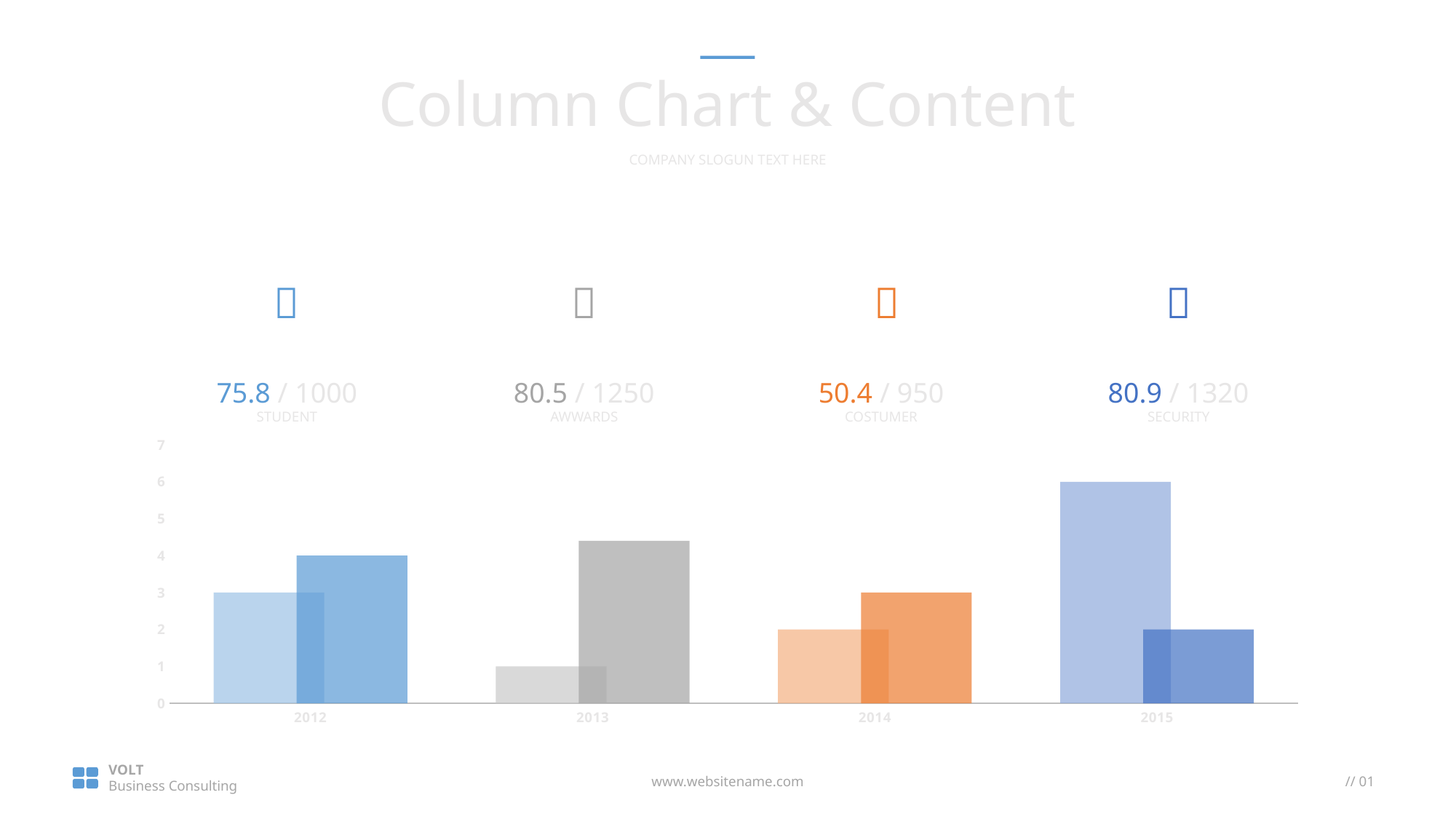
How many year categories are shown on the x axis of the chart? 4 Is the value of the darker bar for 2015 greater or less than 3? less What is the title of the slide containing the chart? Column Chart & Content Which year has the shortest bar in the chart? 2013 Is the value of the taller (lighter) bar for 2015 greater or less than 5? greater Is the value of the shorter (lighter) bar for 2013 greater or less than 2? less Which is larger: the darker bar for 2012 or the darker bar for 2014? 2012 What kind of chart is shown on the slide? bar chart Which is larger: the lighter bar for 2015 or the darker bar for 2013? the lighter bar for 2015 What colour are the bars for 2014 in the chart? orange Which year has the tallest bar in the chart? 2015